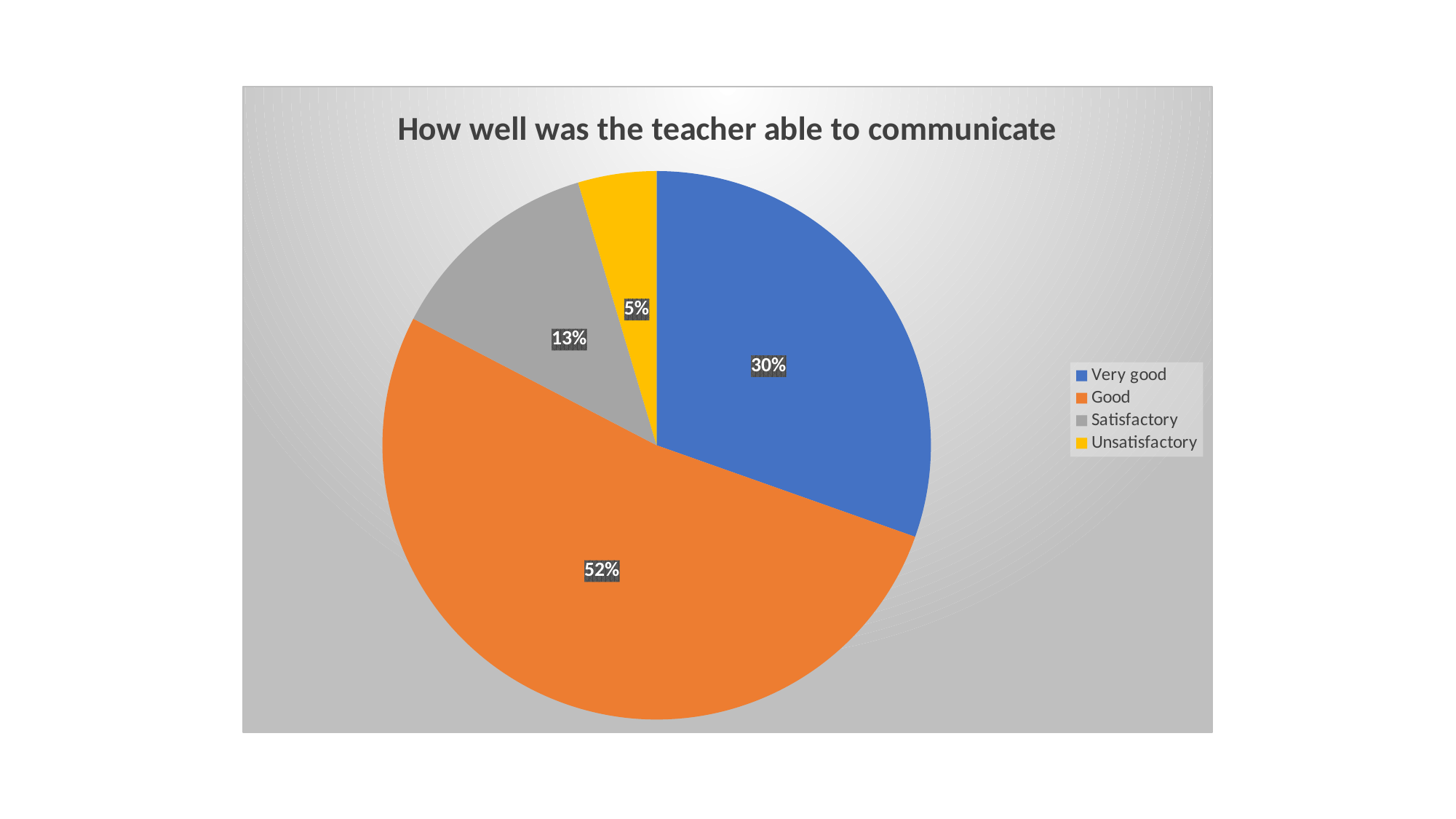
What is the title of the chart? How well was the teacher able to communicate What type of chart is shown on the slide? pie chart What percentage of responses were 'Unsatisfactory'? 5% Which is larger, the share for 'Satisfactory' or the share for 'Unsatisfactory'? Satisfactory What is the difference in percentage points between 'Good' and 'Very good'? 22 What percentage of responses were 'Good'? 52% How many categories does the legend list? 4 Which category has the smallest share of the pie? Unsatisfactory What percentage of responses were 'Satisfactory'? 13% What colour represents the 'Satisfactory' category? grey Which category has the largest share of the pie? Good What percentage of responses were 'Very good'? 30%